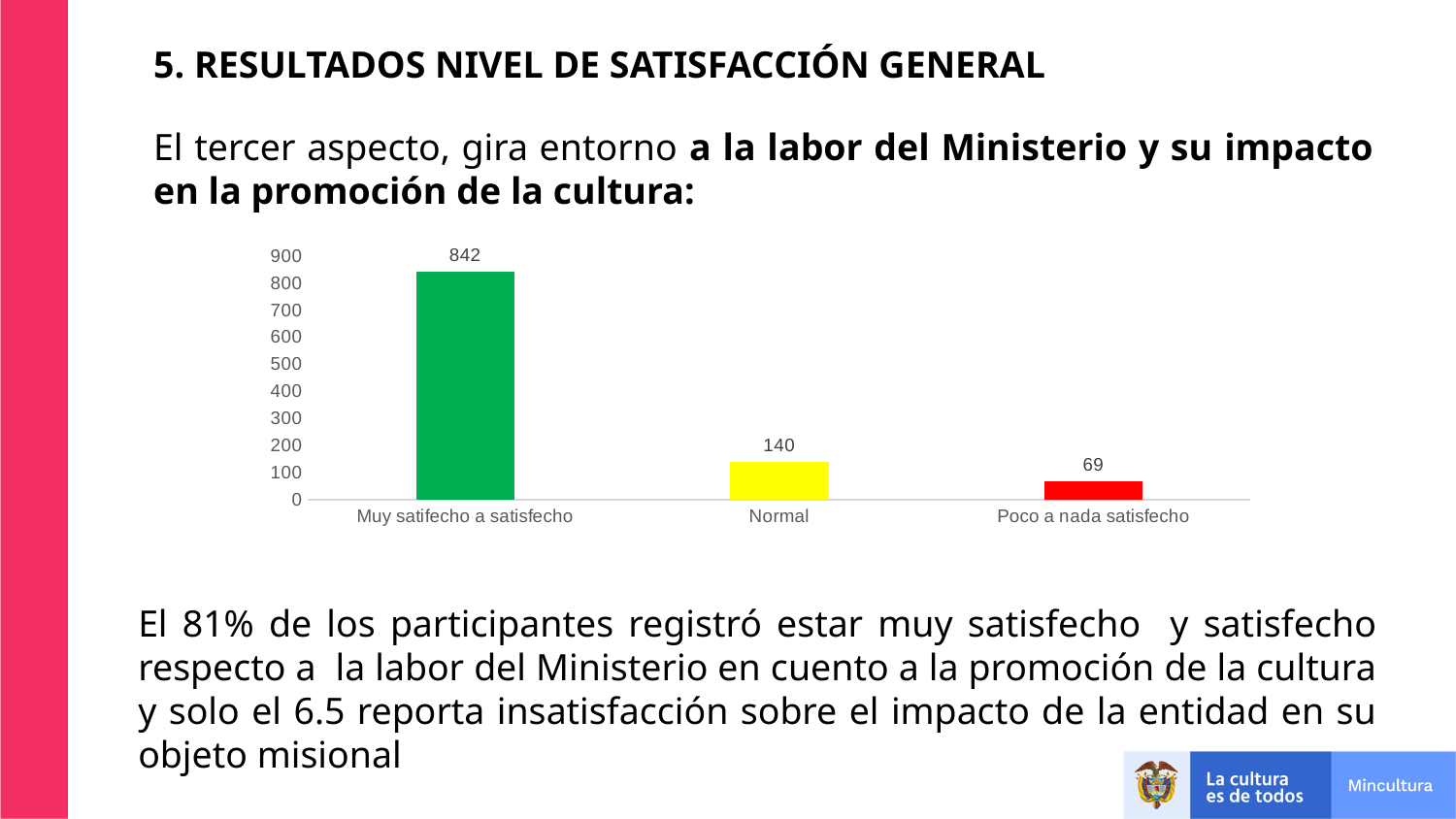
What is the value for "Muy satifecho a satisfecho"? 842 Is the value for "Muy satifecho a satisfecho" greater or less than 800? greater What is the difference between the values for "Muy satifecho a satisfecho" and "Normal"? 702 How many categories are shown on the x axis? 3 What is the value for "Poco a nada satisfecho"? 69 What is the value for "Normal"? 140 What kind of chart is shown on the slide? bar chart Which is larger, the value for "Normal" or the value for "Poco a nada satisfecho"? Normal Which category has the lowest value? Poco a nada satisfecho What is the difference between the values for "Normal" and "Poco a nada satisfecho"? 71 What colour is the bar for "Normal"? yellow Which category has the highest value? Muy satifecho a satisfecho